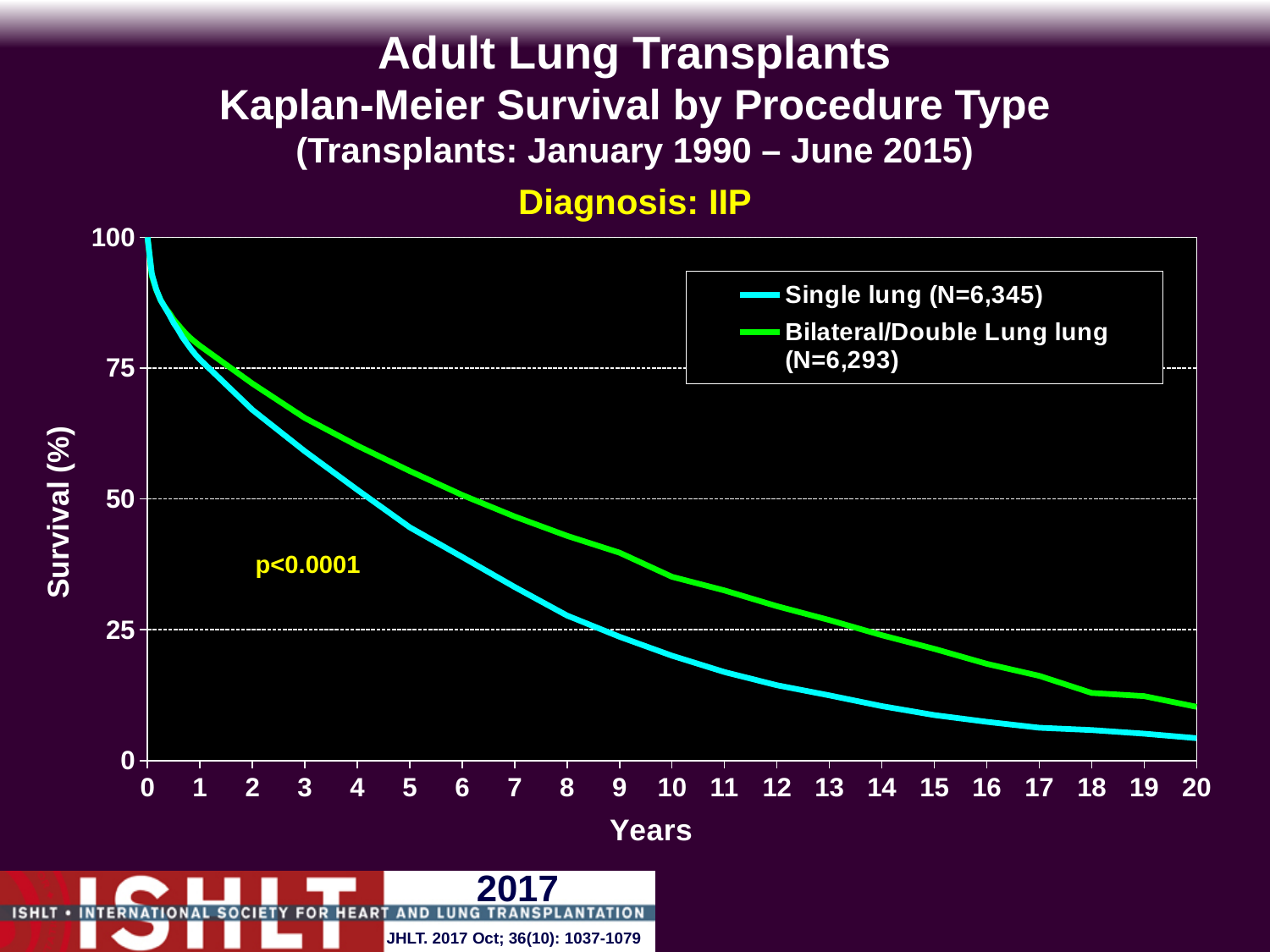
What kind of chart is shown on the slide? Line chart Is the survival value for Single lung at 5 years greater or less than 50? less At 10 years, which procedure type has the higher survival, Single lung or Bilateral/Double Lung? Bilateral/Double Lung Is the survival value for Bilateral/Double Lung at 15 years greater or less than 25? less Is the survival value for Bilateral/Double Lung at 10 years greater or less than 25? greater Do the survival curves rise or fall as years increase? Fall What p-value is printed on the chart? p<0.0001 How many series does the legend list? 2 What is the N for the Single lung series shown in the legend? 6,345